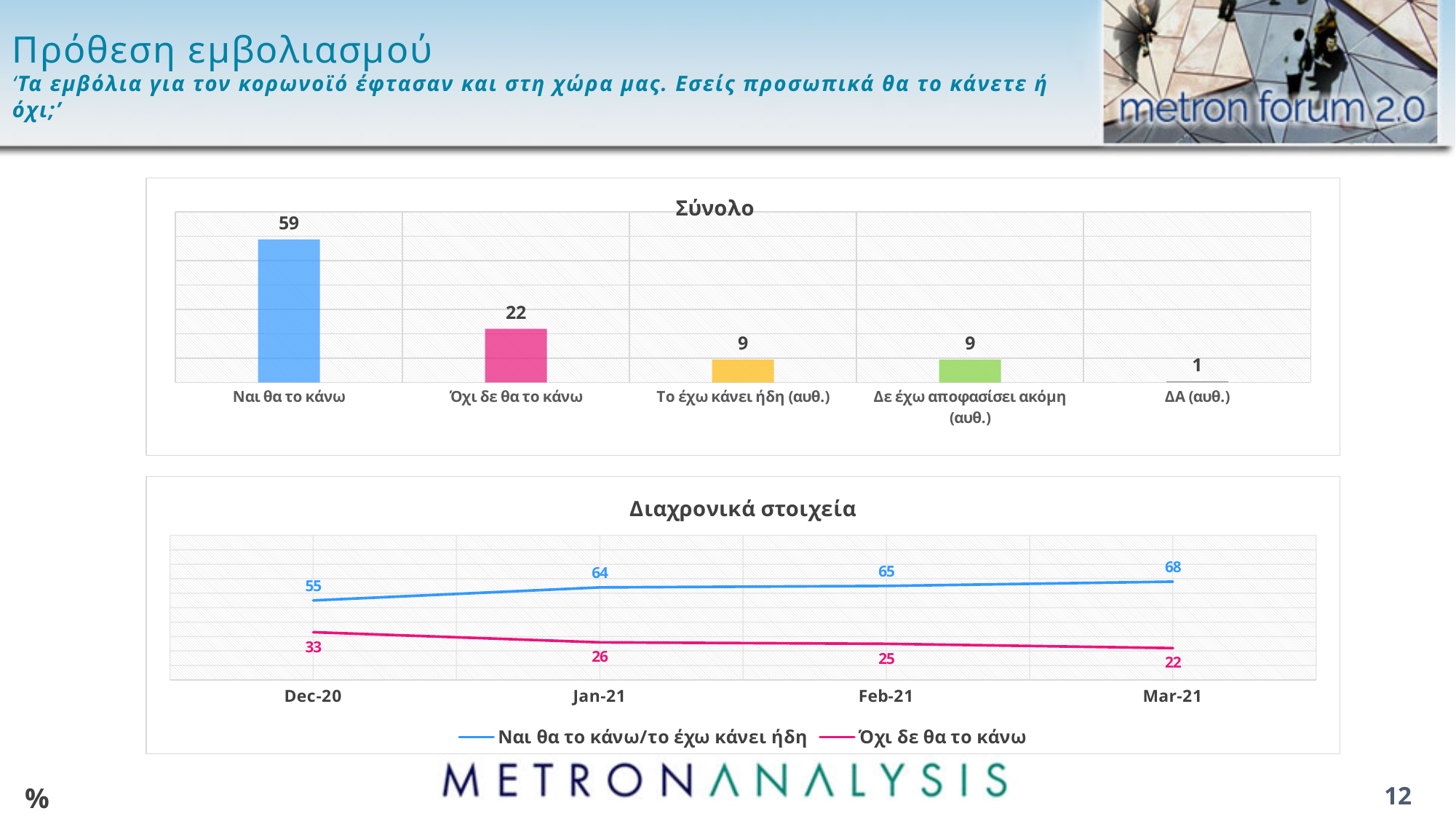
In the 'Σύνολο' chart, which category has the highest value? Ναι θα το κάνω In the 'Διαχρονικά στοιχεία' chart, what is the difference between the two series in Dec-20? 22 In the 'Διαχρονικά στοιχεία' chart, how many series does the legend list? 2 What kind of chart is the 'Διαχρονικά στοιχεία' chart? Line chart In the 'Σύνολο' chart, which category has the lowest value? ΔΑ (αυθ.) In the 'Διαχρονικά στοιχεία' chart, what is the value for 'Όχι δε θα το κάνω' in Feb-21? 25 In the 'Σύνολο' chart, what is the difference between 'Ναι θα το κάνω' and 'Όχι δε θα το κάνω'? 37 In the 'Σύνολο' chart, what is the value for 'Ναι θα το κάνω'? 59 In the 'Σύνολο' chart, how many categories are shown? 5 In the 'Διαχρονικά στοιχεία' chart, what is the value for 'Ναι θα το κάνω/το έχω κάνει ήδη' in Mar-21? 68 In the 'Διαχρονικά στοιχεία' chart, does the 'Όχι δε θα το κάνω' series rise or fall from Dec-20 to Mar-21? Fall What kind of chart is the 'Σύνολο' chart? Bar chart